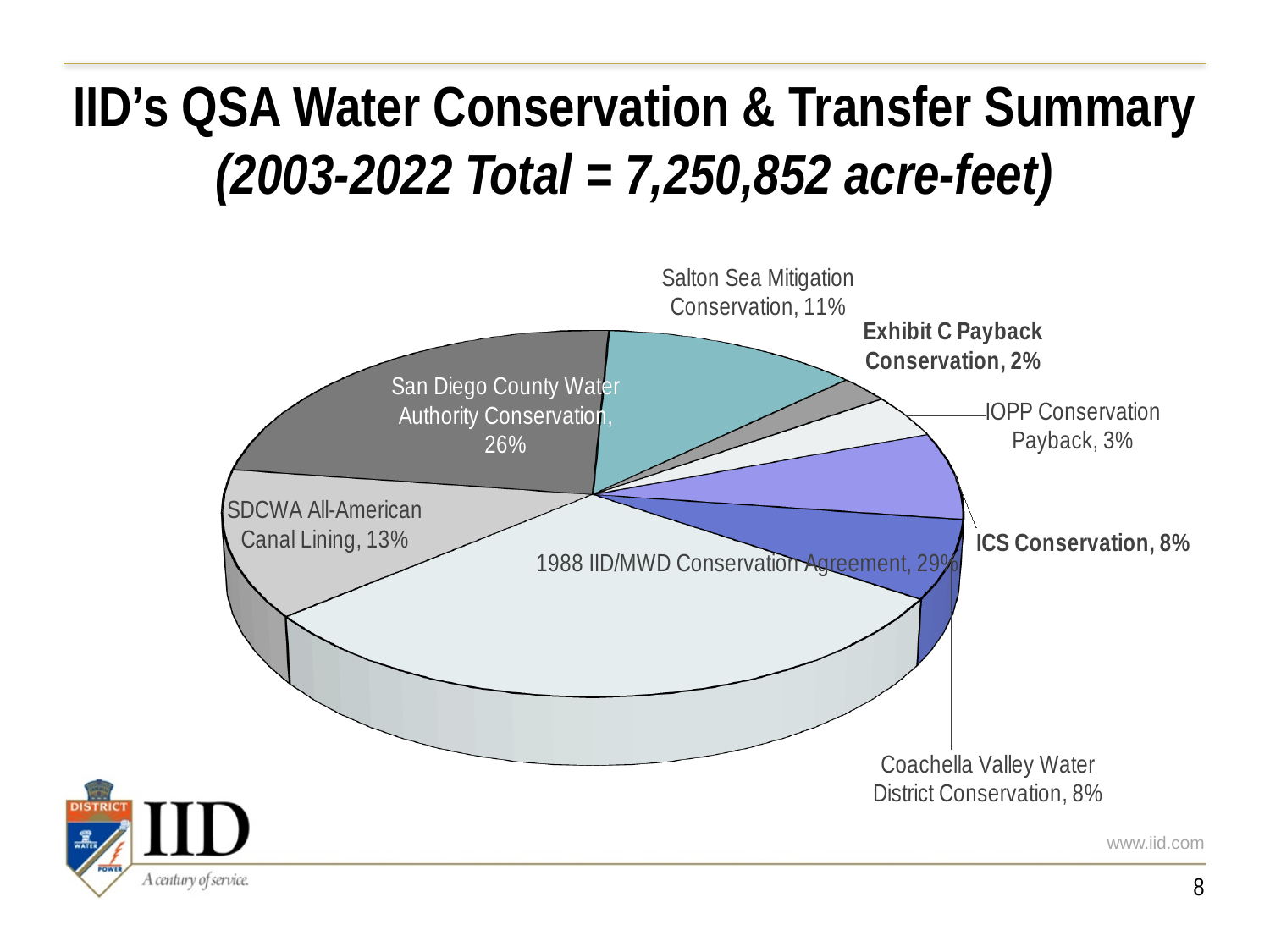
Which category has the smallest share of the pie? Exhibit C Payback Conservation What total volume in acre-feet does the slide title give for 2003-2022? 7,250,852 acre-feet Which category has the largest share of the pie? 1988 IID/MWD Conservation Agreement What percentage is shown for Salton Sea Mitigation Conservation? 11% Which is larger, Salton Sea Mitigation Conservation or SDCWA All-American Canal Lining? SDCWA All-American Canal Lining How many slices does the pie chart have? 8 What is the difference in percentage points between the 1988 IID/MWD Conservation Agreement and San Diego County Water Authority Conservation? 3 percentage points What share of the pie does the 1988 IID/MWD Conservation Agreement represent? 29% What percentage is shown for IOPP Conservation Payback? 3% What percentage is shown for San Diego County Water Authority Conservation? 26% What percentage is shown for SDCWA All-American Canal Lining? 13% What kind of chart is shown on the slide? Pie chart